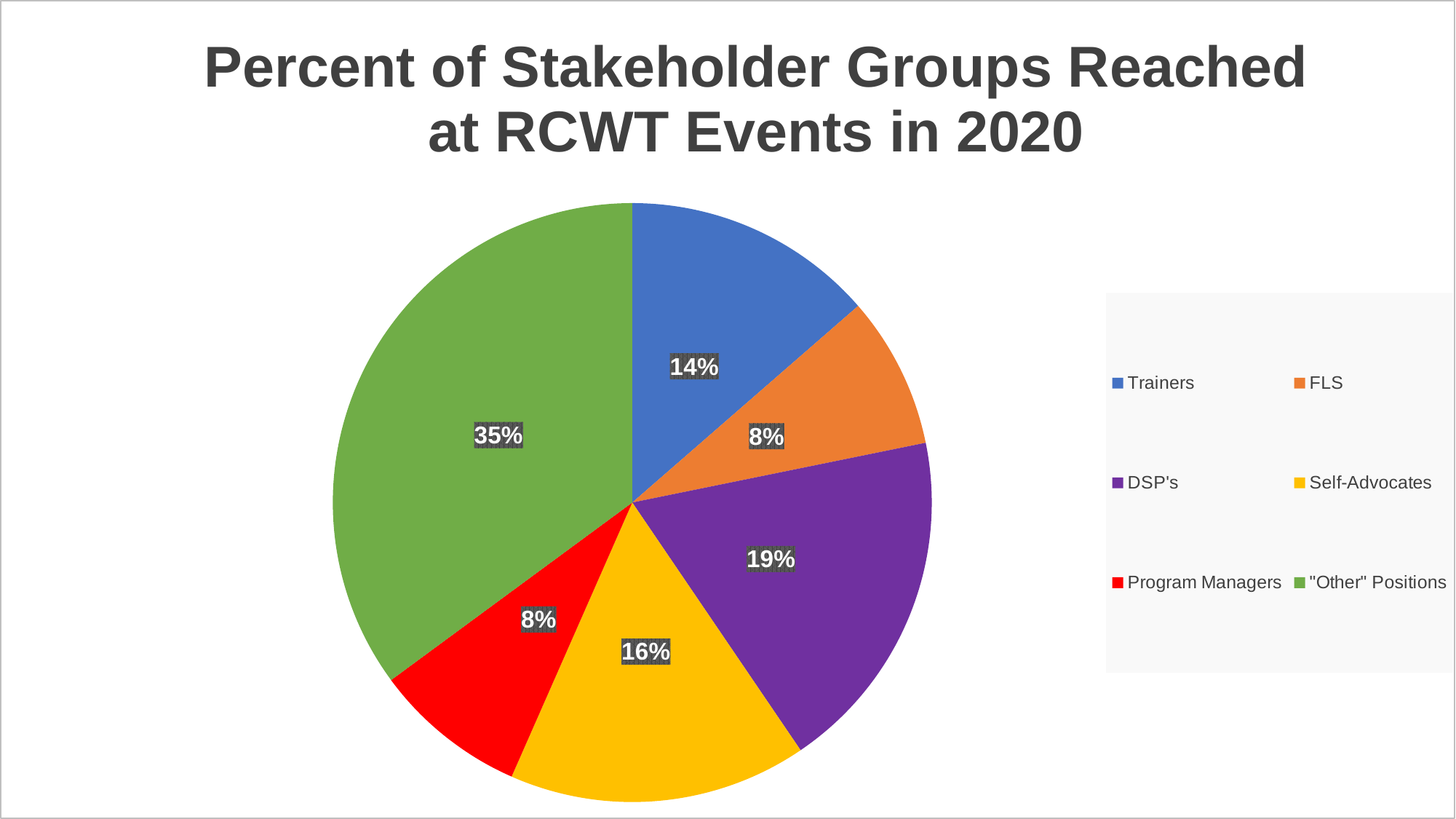
Which is larger, the Trainers slice or the Self-Advocates slice? Self-Advocates What percentage of the pie is the "Other" Positions slice? 35% What percentage of the pie is the Self-Advocates slice? 16% What is the difference between the "Other" Positions share and the DSP's share? 16% What percentage of the pie is the Trainers slice? 14% What is the title of the chart? Percent of Stakeholder Groups Reached at RCWT Events in 2020 What percentage of the pie is the FLS slice? 8% What colour is the Program Managers slice? red What type of chart is shown on the slide? pie chart Which stakeholder group has the largest share of the pie? "Other" Positions How many slices does the pie chart have? 6 What percentage of the pie is the DSP's slice? 19%